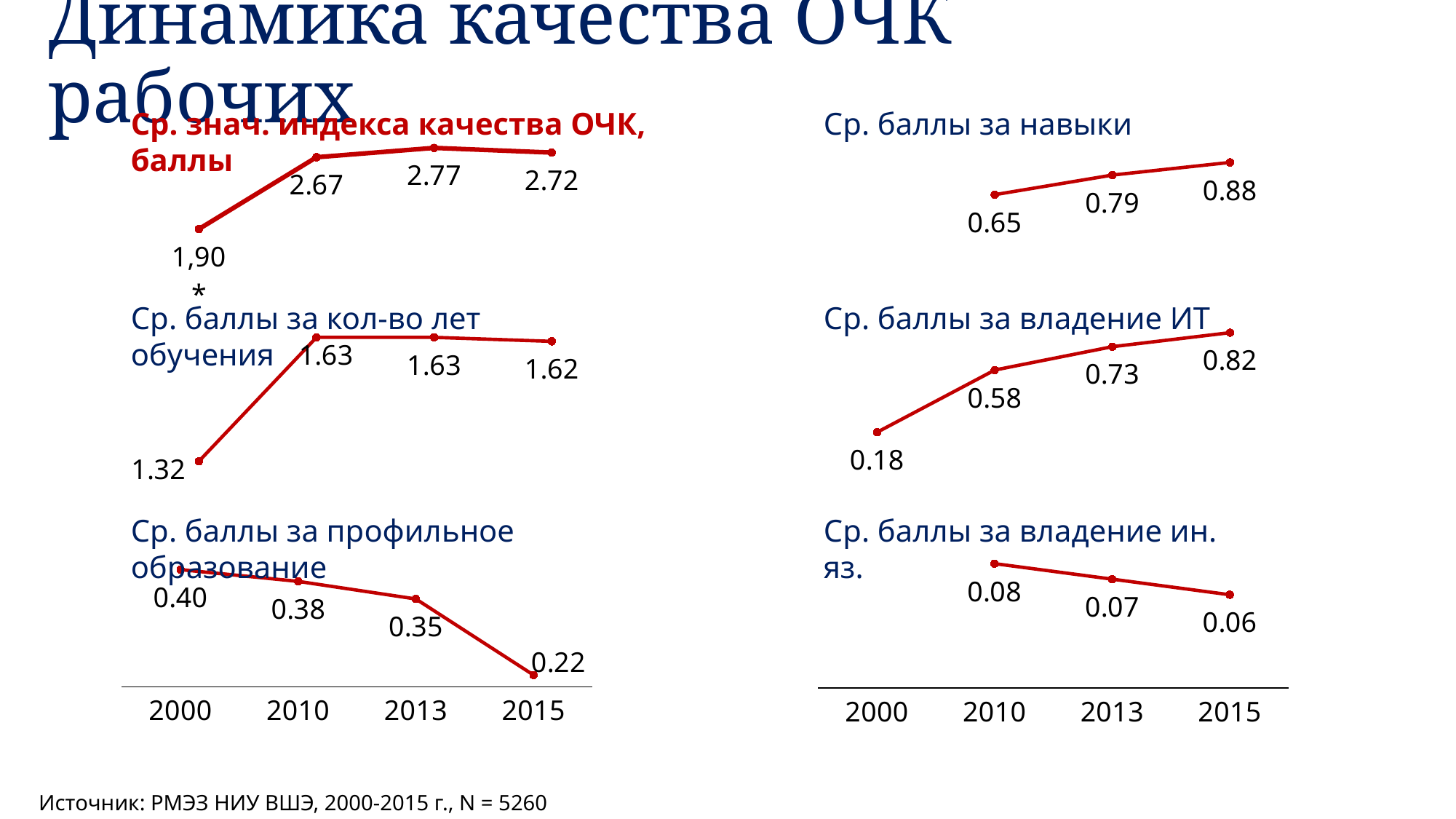
In the chart 'Ср. баллы за владение ИТ', do the values rise or fall from 2000 to 2015? rise In the chart 'Ср. баллы за навыки', what is the value for 2015? 0.88 What type of chart is used for 'Ср. баллы за владение ИТ'? line chart In the chart 'Ср. баллы за владение ин. яз.', which year has the highest value? 2010 In the chart 'Ср. баллы за навыки', how many data points are plotted? 3 In the chart 'Ср. баллы за профильное образование', what is the value for 2015? 0.22 In the chart 'Ср. баллы за кол-во лет обучения', what is the value for 2000? 1.32 In the chart 'Ср. баллы за кол-во лет обучения', which year has the lowest value? 2000 In the chart 'Ср. баллы за владение ИТ', what is the difference between the 2015 and 2000 values? 0.64 In the chart 'Ср. знач. индекса качества ОЧК, баллы', what is the value for 2013? 2.77 In the chart 'Ср. баллы за профильное образование', do the values rise or fall from 2000 to 2015? fall In the chart 'Ср. знач. индекса качества ОЧК, баллы', what is the value for 2000? 1,90